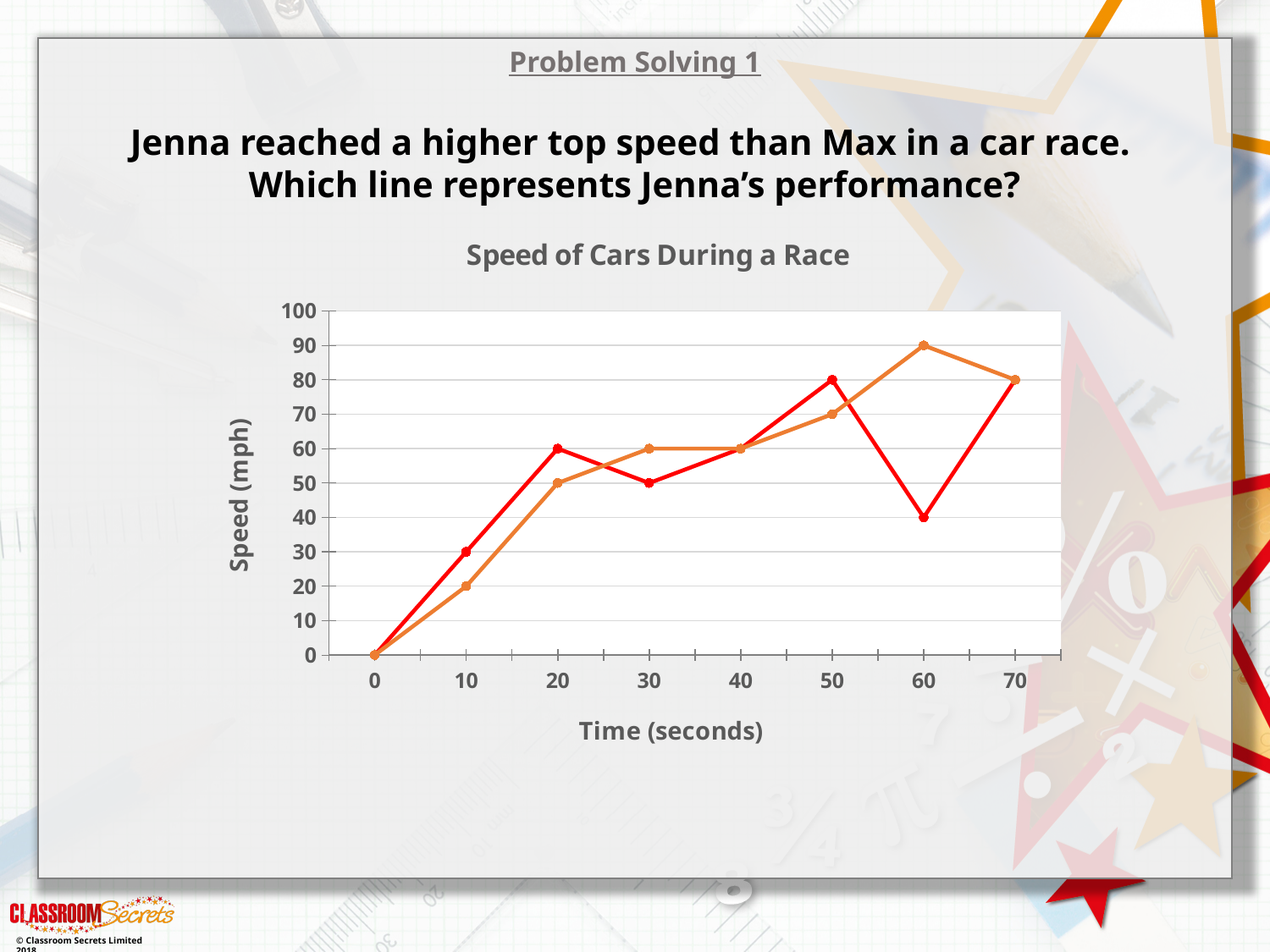
What kind of chart is shown on the slide? line chart What is the label of the y axis? Speed (mph) What is the highest speed reached by the orange line? 90 What is the speed of the orange line at 20 seconds? 50 What is the speed of the orange line at 60 seconds? 90 What is the speed of the red line at 60 seconds? 40 How many time points are plotted on the x axis? 8 What is the title of the chart? Speed of Cars During a Race What is the speed of the red line at 10 seconds? 30 At 30 seconds, which line has the higher speed, red or orange? orange What is the difference between the orange line and the red line at 60 seconds? 50 At what time does the red line reach its highest speed for the first time? 50